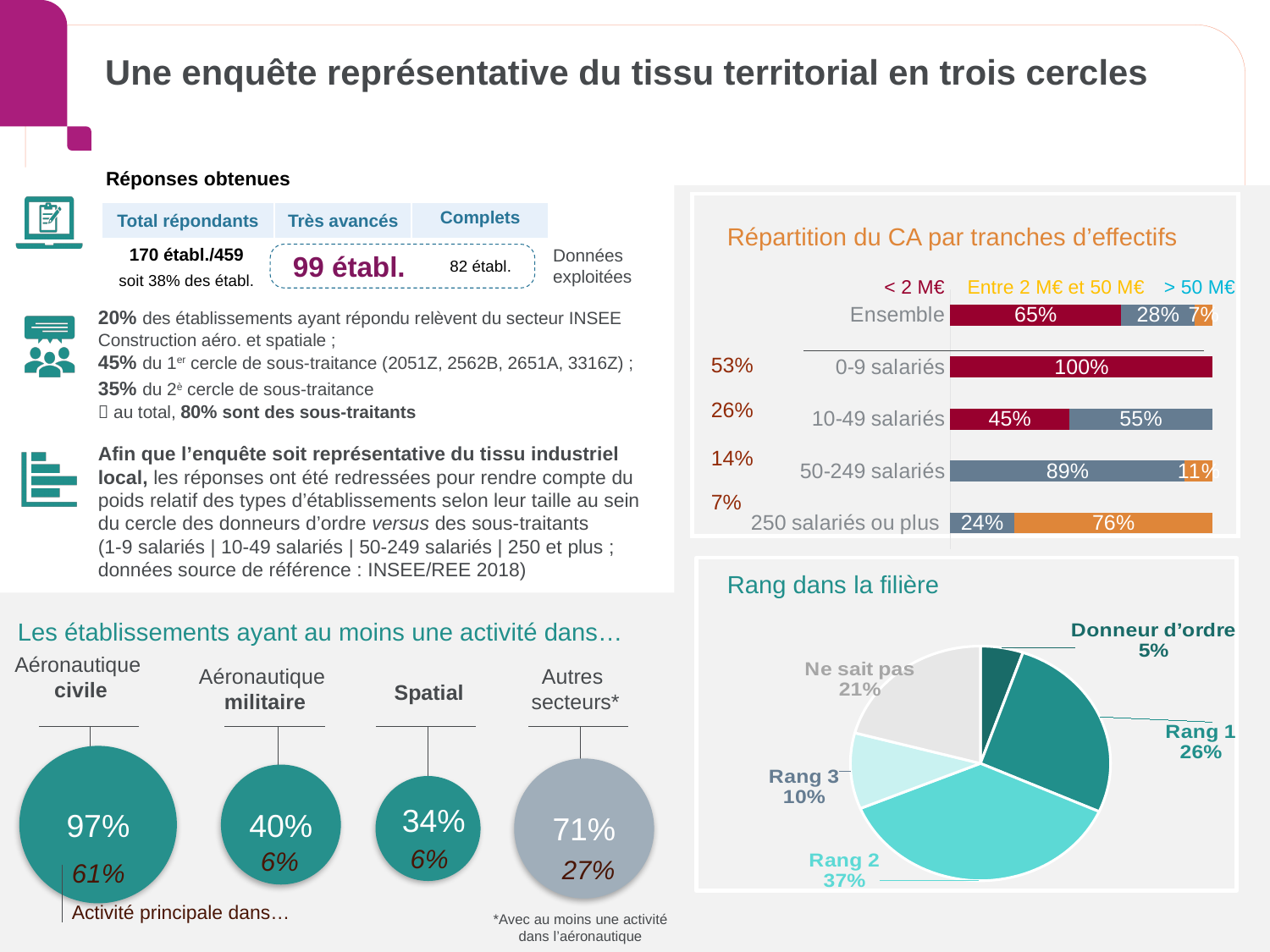
In the 'Répartition du CA par tranches d'effectifs' chart, which is larger for 50-249 salariés: the 'Entre 2 M€ et 50 M€' segment or the '> 50 M€' segment? Entre 2 M€ et 50 M€ In the 'Rang dans la filière' pie chart, what is the difference between the Rang 1 share and the Rang 3 share? 16% What kind of chart is 'Rang dans la filière'? Pie chart In the 'Répartition du CA par tranches d'effectifs' chart, how many series does the legend list? 3 In the 'Rang dans la filière' pie chart, how many slices are there? 5 In the 'Répartition du CA par tranches d'effectifs' chart, what is the value of the '> 50 M€' segment for 250 salariés ou plus? 76% In the 'Rang dans la filière' pie chart, which slice is the largest? Rang 2 In the 'Rang dans la filière' pie chart, which slice is the smallest? Donneur d'ordre What kind of chart is 'Répartition du CA par tranches d'effectifs'? Stacked bar chart In the 'Répartition du CA par tranches d'effectifs' chart, what is the value of the '< 2 M€' segment for 10-49 salariés? 45% In the 'Répartition du CA par tranches d'effectifs' chart, how many employee-size categories are plotted, including Ensemble? 5 In the 'Rang dans la filière' pie chart, what share is labelled for Rang 2? 37%